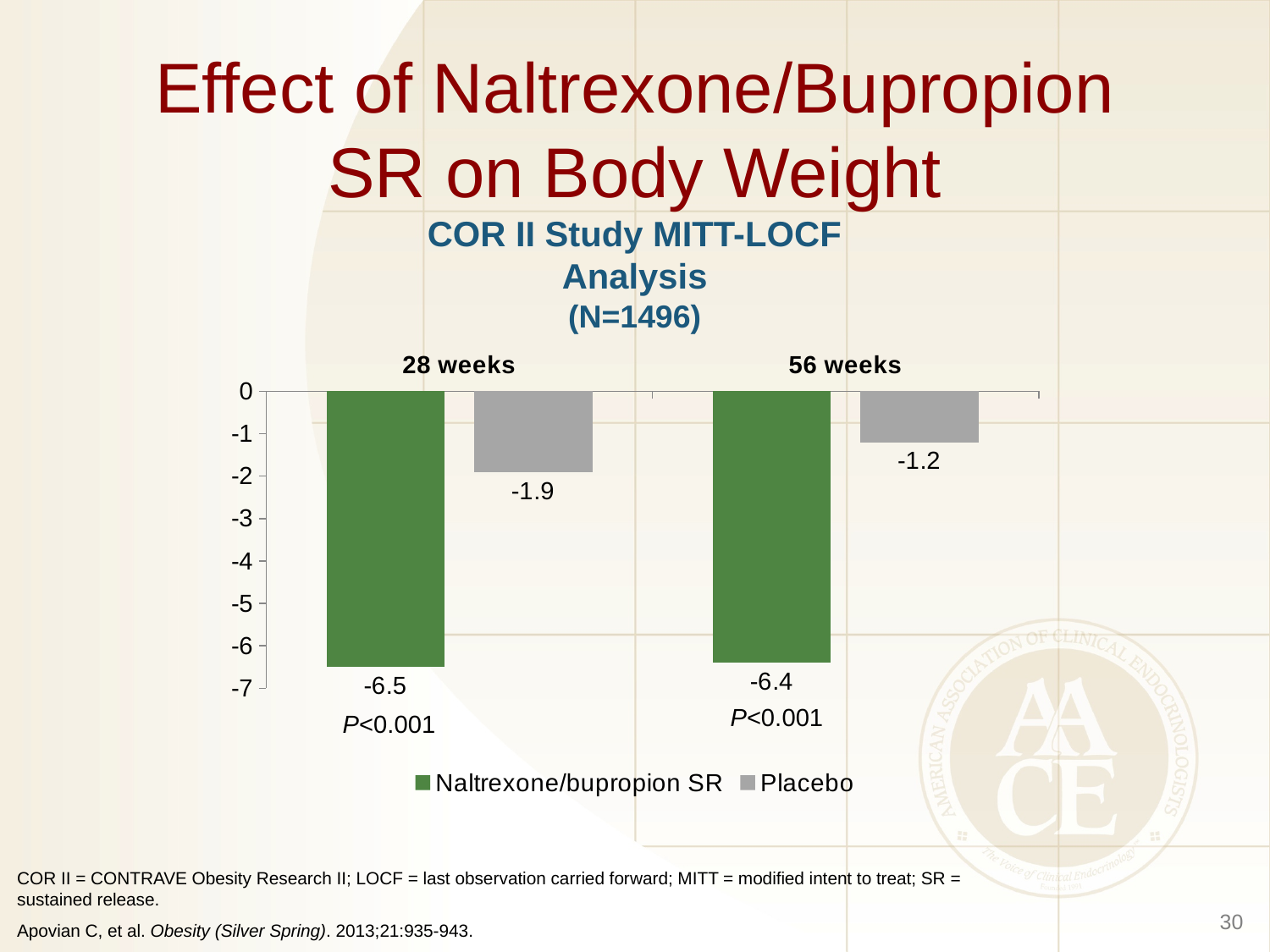
What is the value for Naltrexone/bupropion SR at 56 weeks? -6.4 Which series has the lowest value at 28 weeks? Naltrexone/bupropion SR What is the difference between the Naltrexone/bupropion SR and Placebo values at 56 weeks? 5.2 What is the value for Placebo at 28 weeks? -1.9 What is the value for Naltrexone/bupropion SR at 28 weeks? -6.5 How many time-point categories are shown on the chart? 2 What kind of chart is shown on the slide? Bar chart What is the difference between the Placebo values at 28 weeks and 56 weeks? 0.7 Which is larger in magnitude, the Placebo value at 28 weeks or at 56 weeks? 28 weeks How many series does the legend list? 2 What colour represents Placebo in the chart? Grey What is the value for Placebo at 56 weeks? -1.2